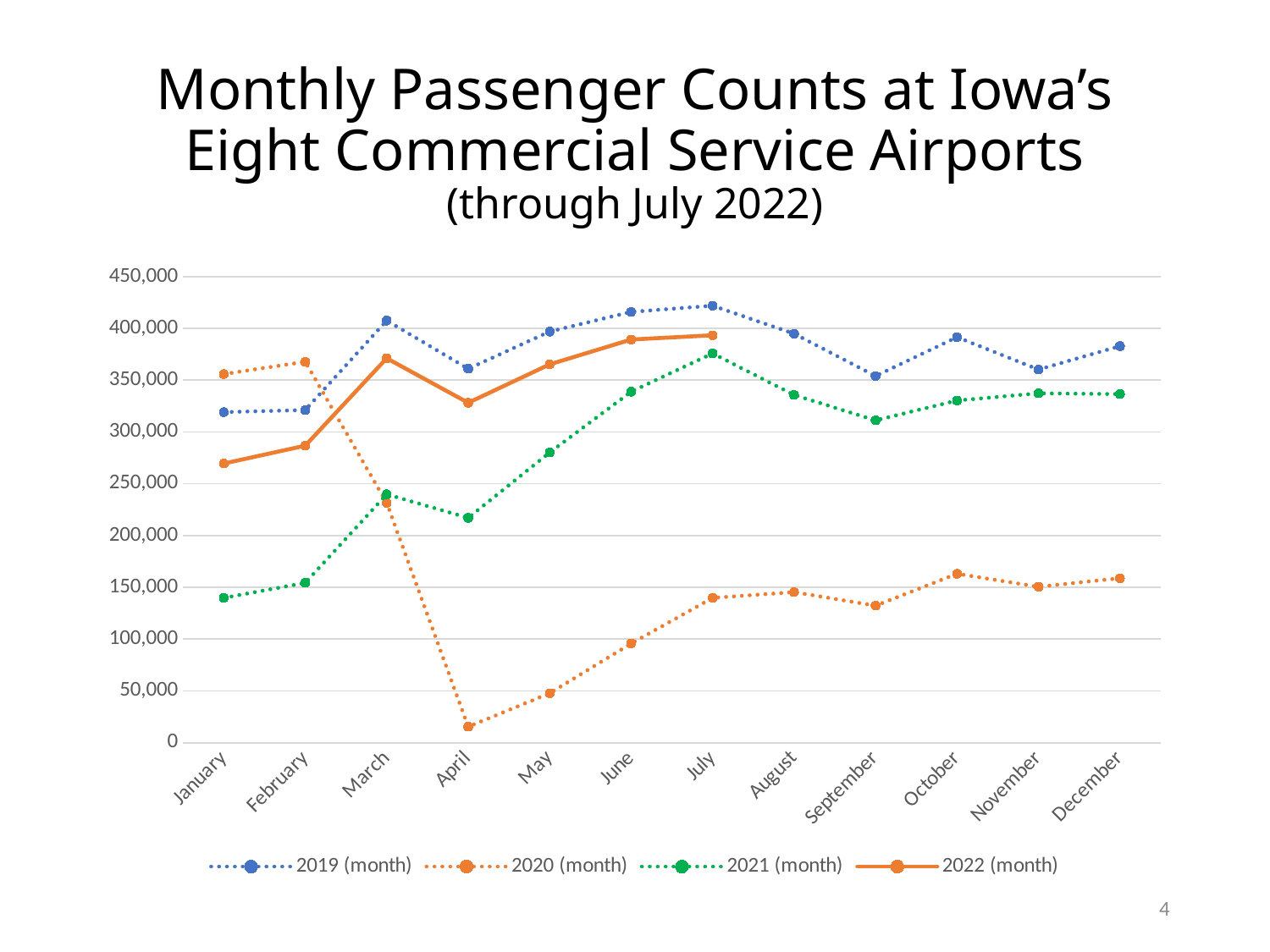
Is the value for 2022 (month) in January greater or less than 250,000? greater Does the 2021 (month) series rise or fall from January to July? rise In which month does the 2021 (month) series reach its highest value? July Is the value for 2020 (month) in April greater or less than 50,000? less Which is larger in January: the 2019 (month) value or the 2020 (month) value? 2020 (month) What kind of chart is shown on the slide? line chart In which month does the 2020 (month) series reach its lowest value? April How many months are shown along the x axis? 12 How many series does the legend list? 4 Which series is drawn with a solid line rather than a dotted line? 2022 (month) In which month does the 2021 (month) series have its lowest value? January Is the value for 2019 (month) in March greater or less than 400,000? greater